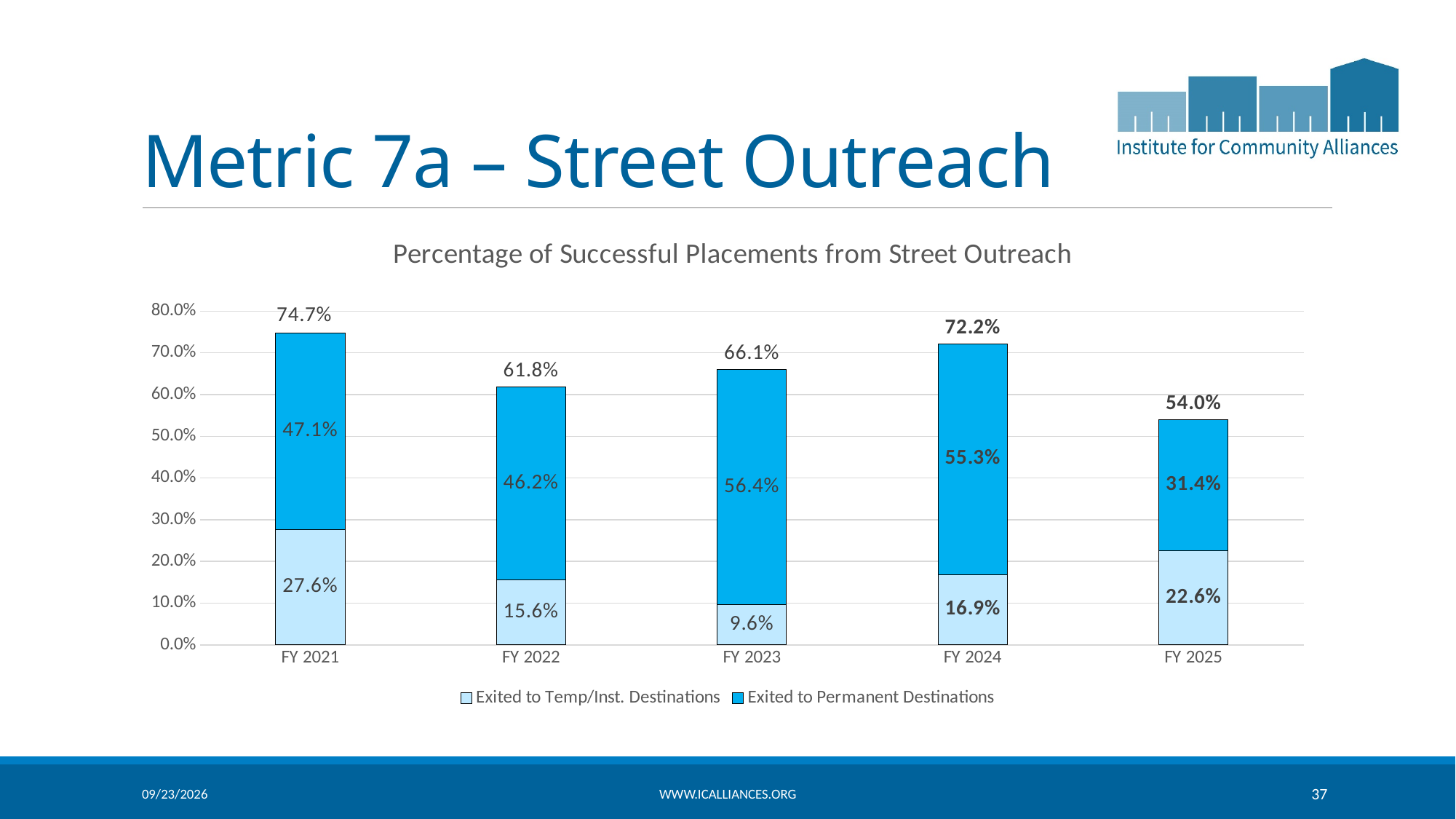
What kind of chart is shown on the slide? Stacked bar chart What is the difference between the Exited to Permanent Destinations values for FY 2024 and FY 2025? 23.9% How many fiscal years are shown on the x axis? 5 What is the value for Exited to Permanent Destinations in FY 2023? 56.4% What is the value for Exited to Temp/Inst. Destinations in FY 2025? 22.6% Does the total percentage rise or fall from FY 2024 to FY 2025? Fall What is the title of the chart? Percentage of Successful Placements from Street Outreach Which fiscal year has the lowest value for Exited to Temp/Inst. Destinations? FY 2023 Which is larger: the Exited to Temp/Inst. Destinations value for FY 2021 or for FY 2024? FY 2021 How many series does the legend list? 2 What is the total of the stacked bar for FY 2022? 61.8% Which fiscal year has the highest total percentage of successful placements? FY 2021